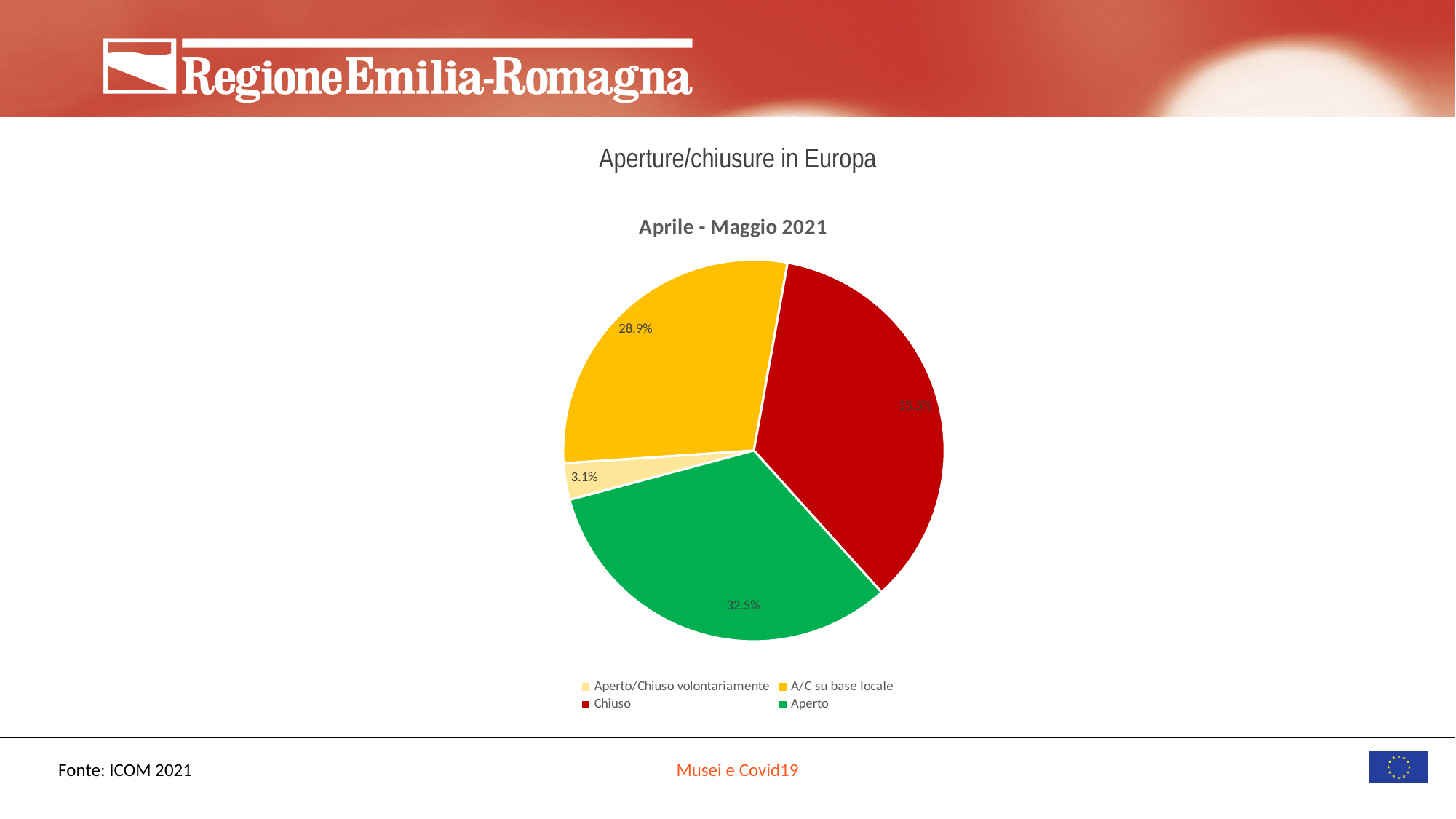
What share of the pie is labelled for the 'A/C su base locale' slice? 28.9% Which slice is larger, 'Aperto' or 'A/C su base locale'? Aperto What is the difference in percentage points between the 'Aperto' slice and the 'Aperto/Chiuso volontariamente' slice? 29.4 percentage points What is the title shown directly above the pie chart? Aprile - Maggio 2021 How many slices does the pie chart have? 4 What share of the pie is labelled for the 'Aperto/Chiuso volontariamente' slice? 3.1% Which slice is larger, 'A/C su base locale' or 'Aperto/Chiuso volontariamente'? A/C su base locale Which category has the smallest slice of the pie? Aperto/Chiuso volontariamente What colour is used for the 'Chiuso' slice in the pie chart? Red What kind of chart is shown on the slide? Pie chart What is the difference in percentage points between the 'Aperto' slice and the 'A/C su base locale' slice? 3.6 percentage points What share of the pie is labelled for the 'Aperto' slice? 32.5%